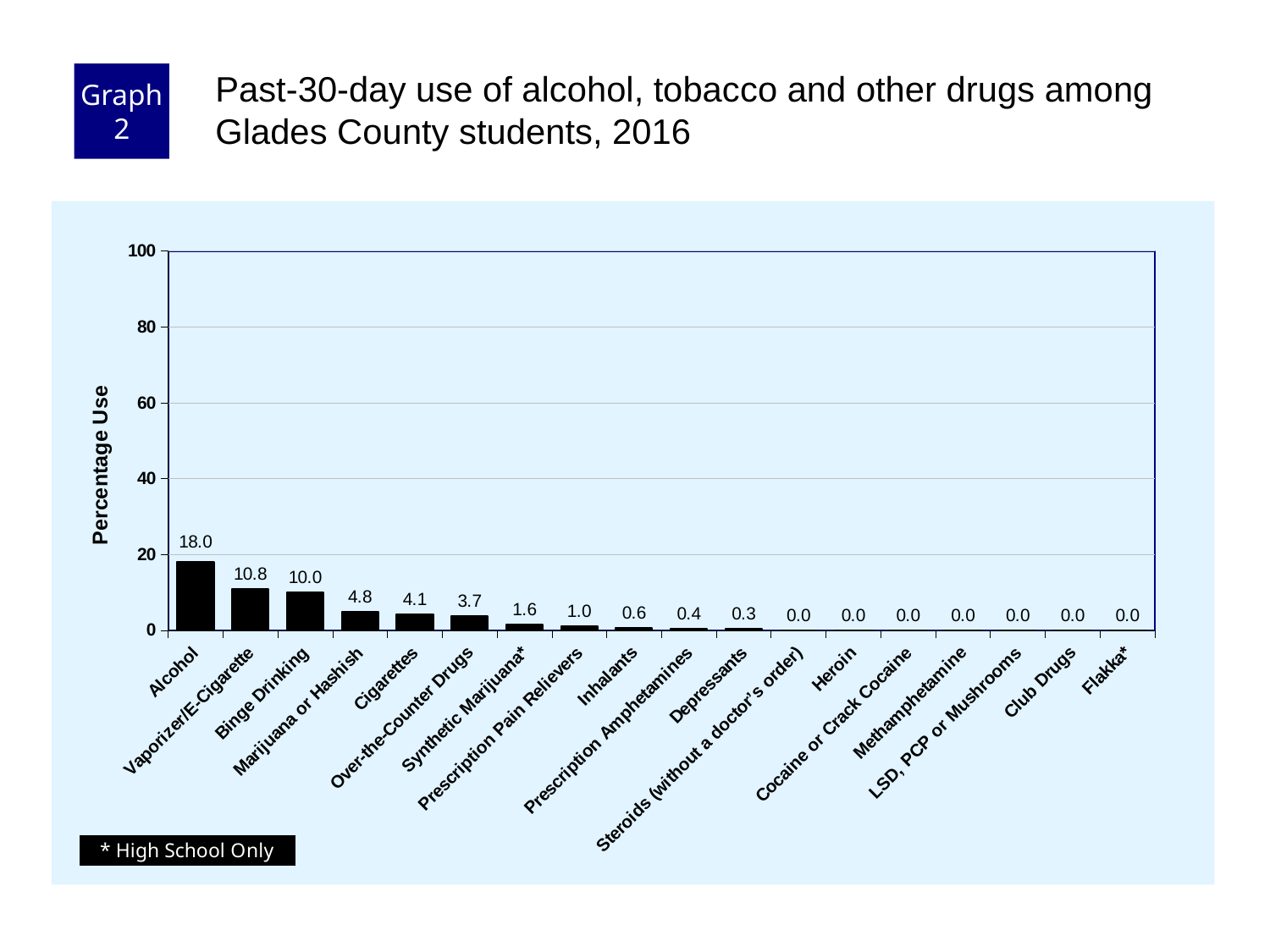
What is the percentage use for Vaporizer/E-Cigarette? 10.8 Is the value for Alcohol greater or less than 20? less What is the difference in percentage use between Alcohol and Binge Drinking? 8.0 What is the percentage use for Synthetic Marijuana*? 1.6 What is the label of the y axis? Percentage Use What is the percentage use for Cigarettes? 4.1 What is the percentage use for Alcohol? 18.0 Do the values rise or fall moving from left to right along the x axis? Fall Which has a higher percentage use, Marijuana or Hashish or Over-the-Counter Drugs? Marijuana or Hashish Which category has the highest percentage use? Alcohol How many categories are shown on the x axis? 18 What kind of chart is shown on the slide? Bar chart